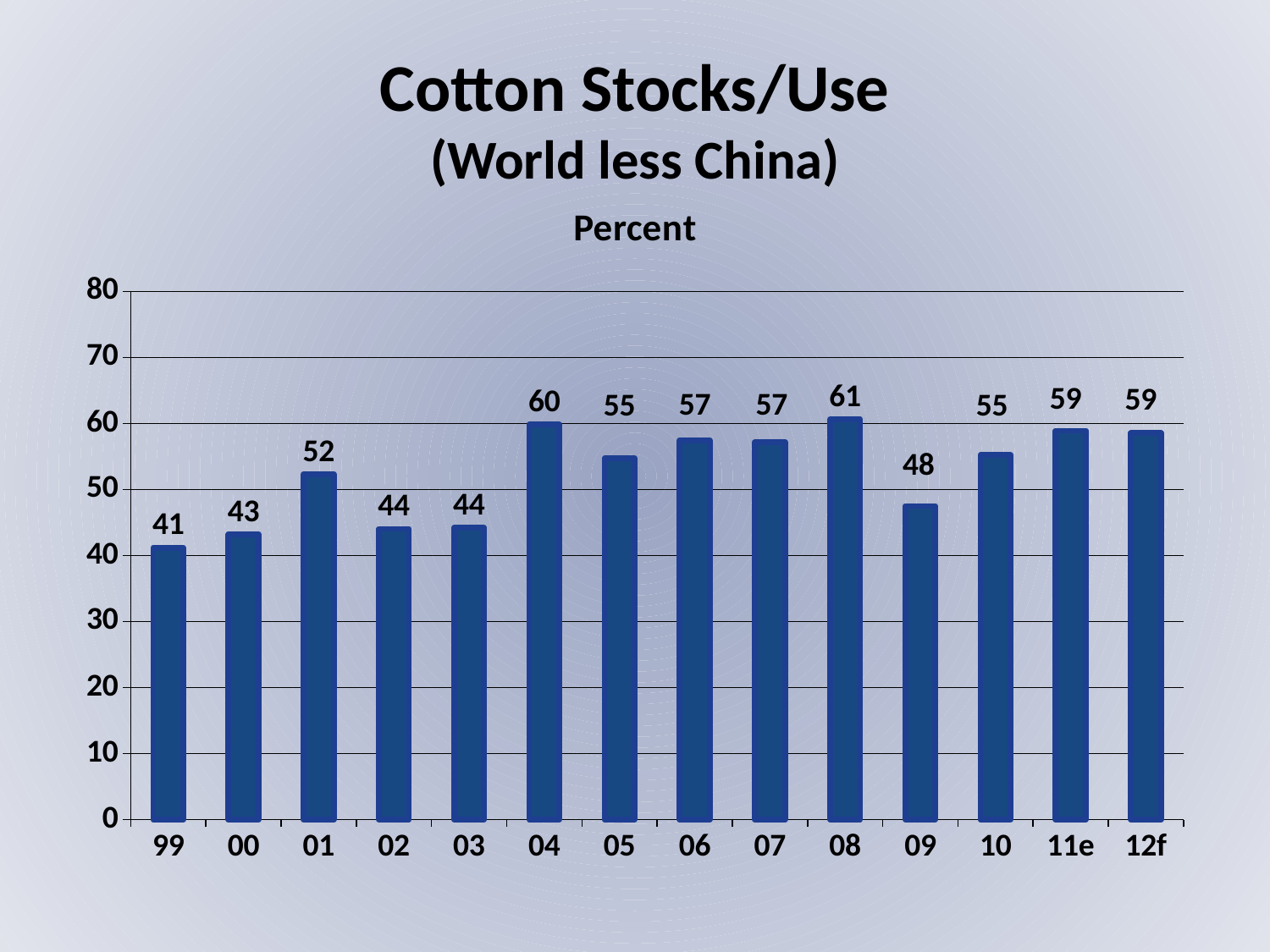
What is the difference between the values for 04 and 03? 16 Which year has the lowest value? 99 Which is larger, the value for 01 or the value for 09? 01 What is the value for 11e? 59 Which year has the highest value? 08 How many years are shown on the x axis? 14 What is the difference between the values for 08 and 09? 13 What is the value for 08? 61 Is the value for 10 greater or less than 50? greater What kind of chart is this? bar chart What is the title of the chart? Cotton Stocks/Use (World less China) What is the value for 99? 41